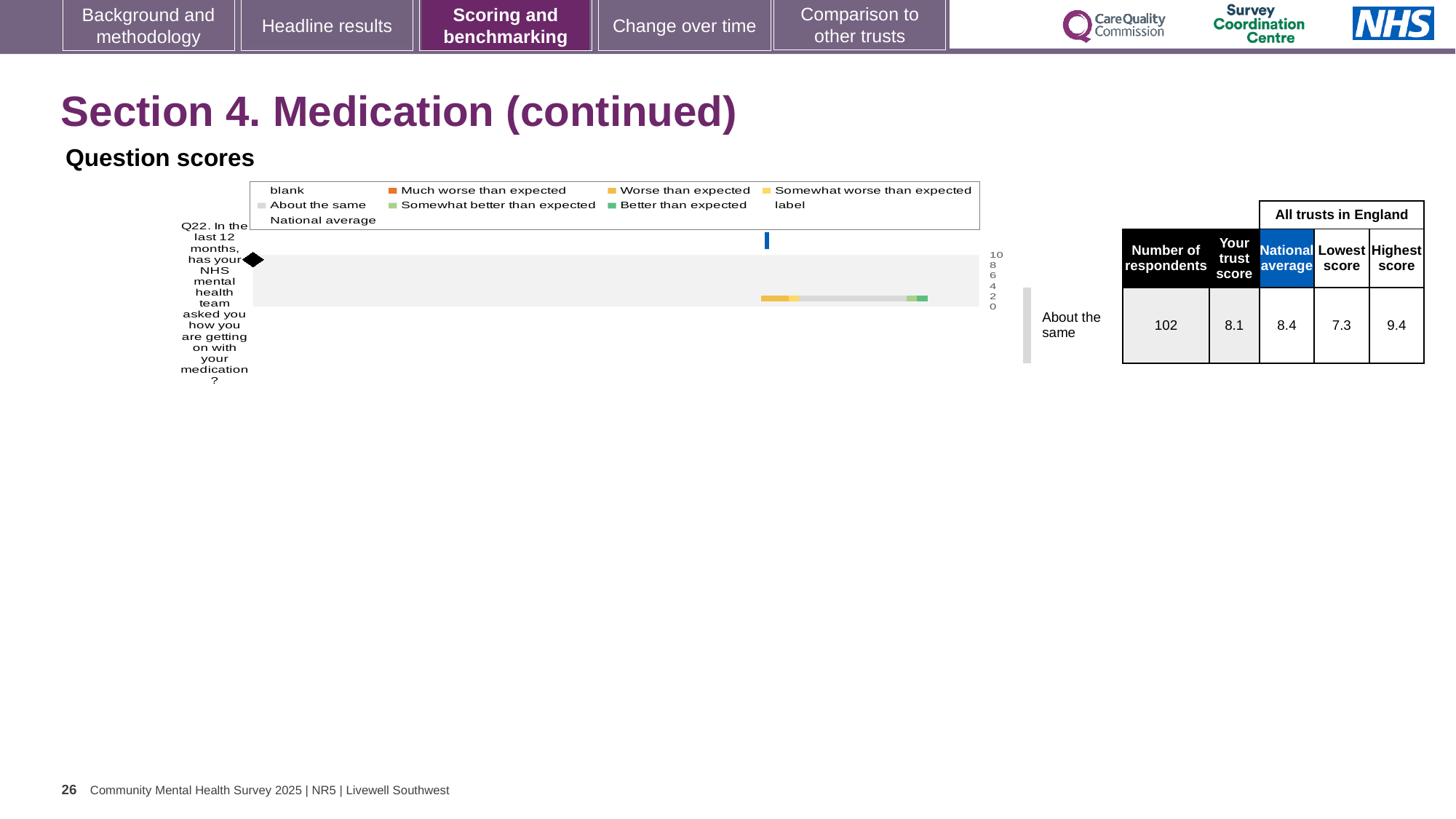
What is the national average score for Q22? 8.4 What is the lowest score among all trusts in England for Q22? 7.3 What is the trust score for Q22? 8.1 Which is larger for Q22, the trust score or the national average? National average What benchmark category is shown next to the bar for Q22? About the same What kind of chart is shown under 'Question scores'? Bar chart What is the difference between the highest and lowest scores among all trusts in England for Q22? 2.1 How many questions are plotted on the Question scores chart? 1 What is the highest score among all trusts in England for Q22? 9.4 How many entries does the legend of the Question scores chart list? 9 Which question is plotted on the Question scores chart? Q22. In the last 12 months, has your NHS mental health team asked you how you are getting on with your medication? What is the number of respondents for Q22? 102